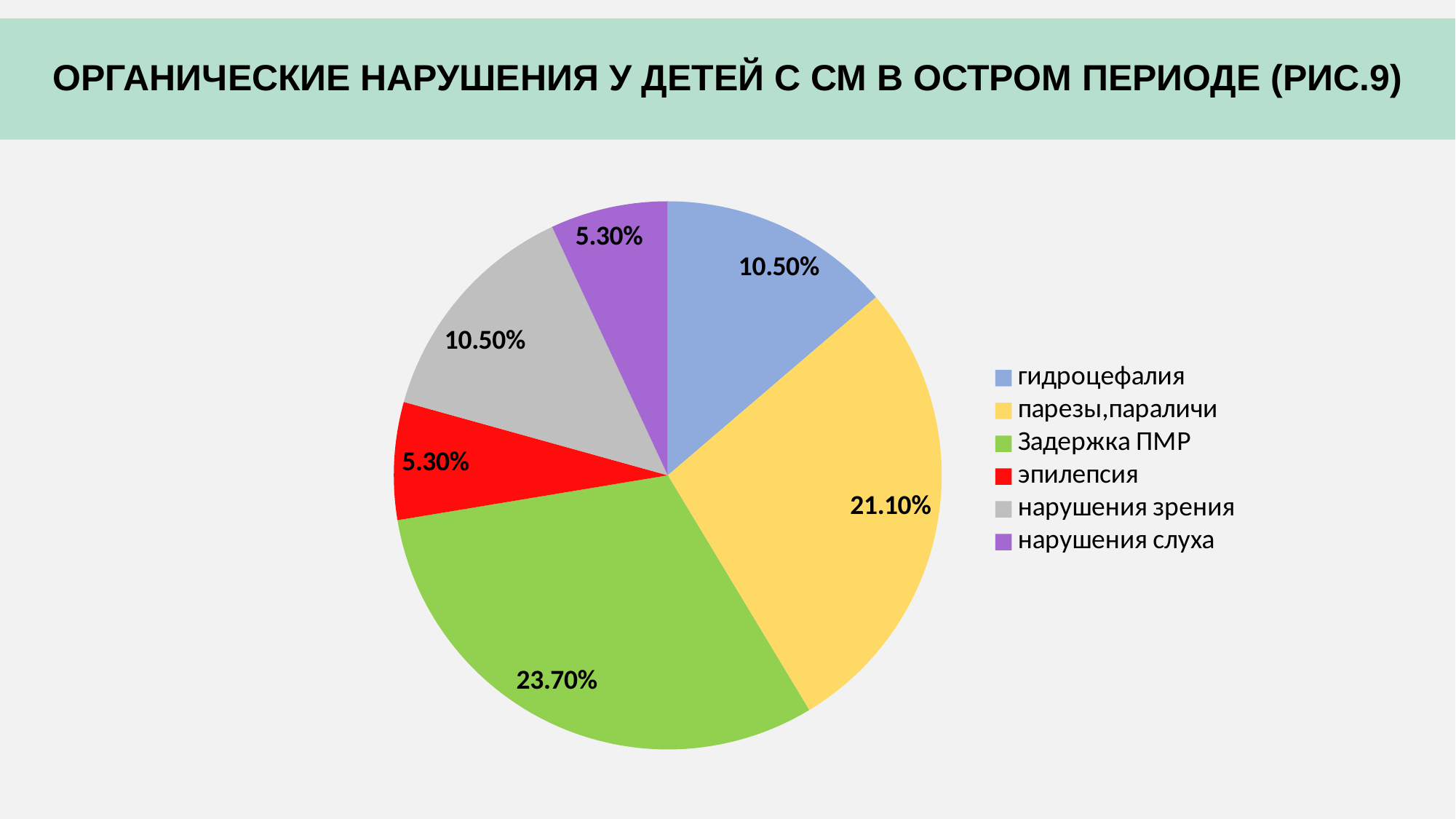
What kind of chart is shown on the slide? pie chart What is the difference between the percentages for нарушения зрения and эпилепсия? 5.20% What percentage is shown for парезы,параличи? 21.10% What percentage is shown for гидроцефалия? 10.50% What colour is the slice for эпилепсия? red What is the difference between the percentages for Задержка ПМР and парезы,параличи? 2.60% What percentage is shown for Задержка ПМР? 23.70% Which category has the largest slice of the pie? Задержка ПМР Which is larger, the slice for гидроцефалия or the slice for нарушения слуха? гидроцефалия What percentage is shown for нарушения зрения? 10.50% How many categories does the legend list? 6 What percentage is shown for эпилепсия? 5.30%